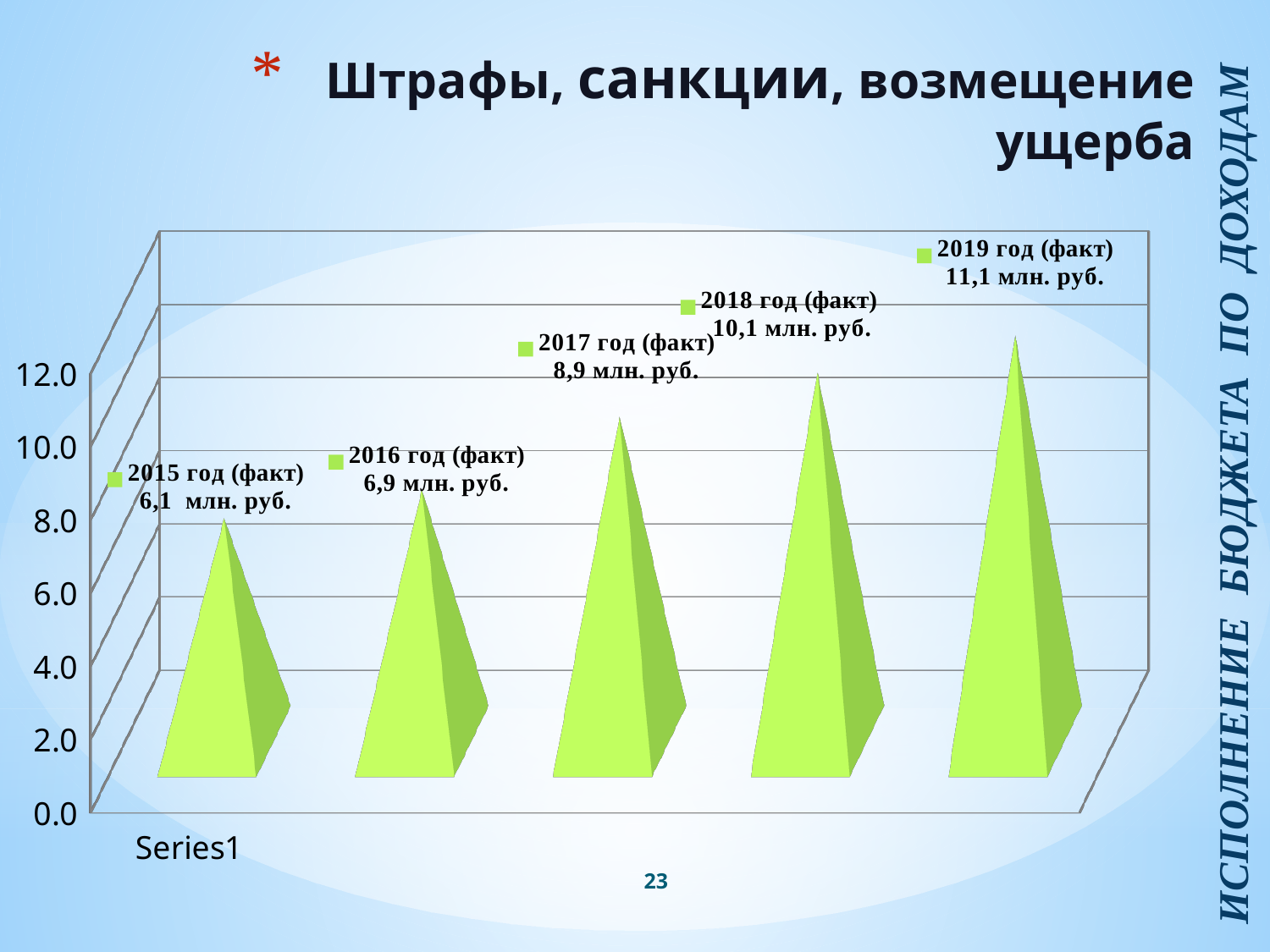
How many years are shown in the chart? 5 What is the value for 2015 год (факт)? 6,1 млн. руб. Which is larger, the value for 2016 год (факт) or 2018 год (факт)? 2018 год (факт) Is the value for 2018 год (факт) greater or less than 10.0? greater Do the values rise or fall from 2015 to 2019? rise What is the value for 2017 год (факт)? 8,9 млн. руб. What is the value for 2019 год (факт)? 11,1 млн. руб. Which year has the lowest value? 2015 год (факт) What is the difference between the values for 2019 год (факт) and 2015 год (факт)? 5,0 млн. руб. What is the title of the chart? Штрафы, санкции, возмещение ущерба Which year has the highest value? 2019 год (факт) What is the difference between the values for 2018 год (факт) and 2017 год (факт)? 1,2 млн. руб.